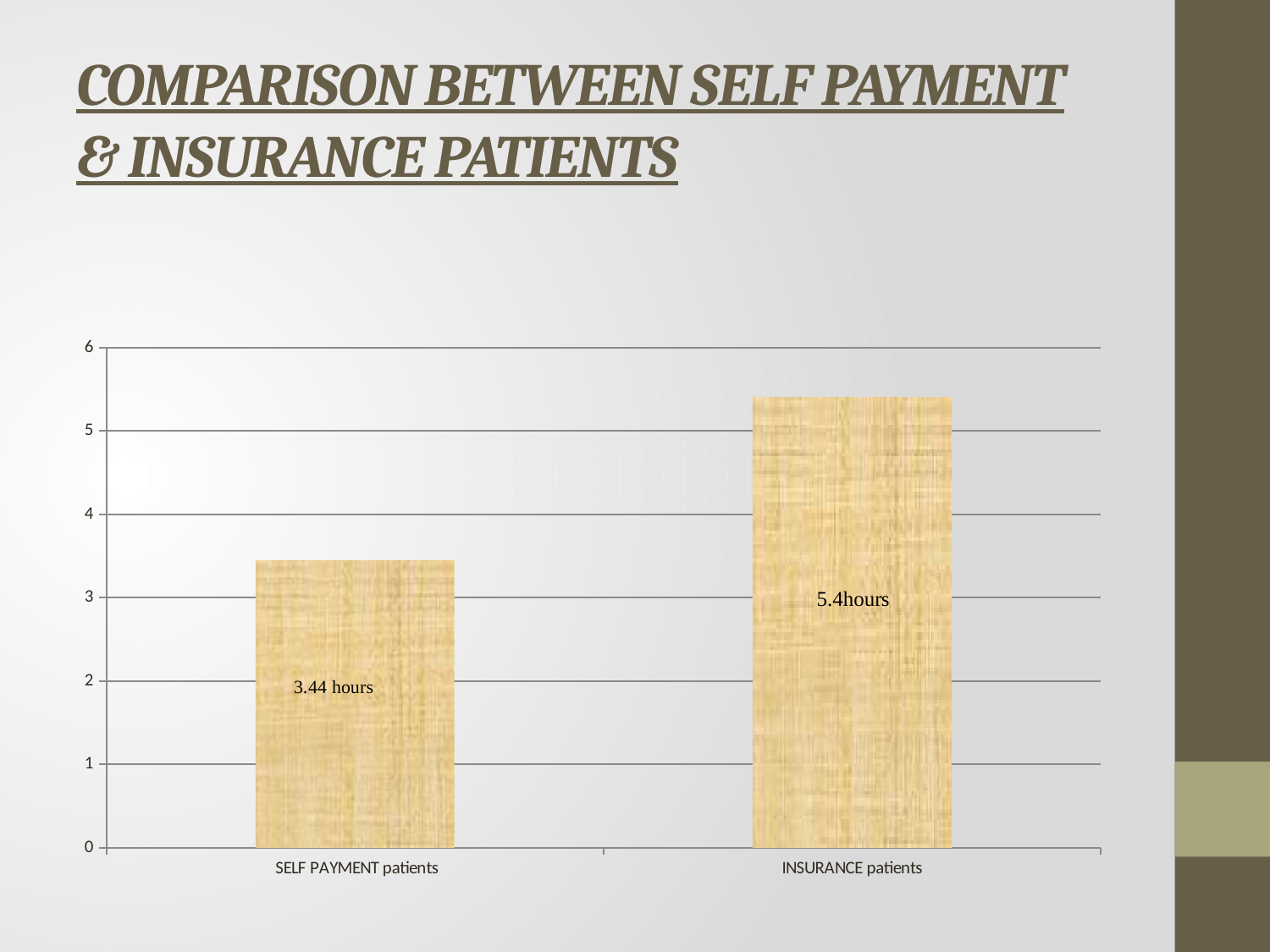
What kind of chart is shown on the slide? bar chart What is the title of the slide containing the chart? COMPARISON BETWEEN SELF PAYMENT & INSURANCE PATIENTS What is the difference in hours between INSURANCE patients and SELF PAYMENT patients? 1.96 hours Is the value for INSURANCE patients greater or less than 5? greater What is the value shown for SELF PAYMENT patients? 3.44 hours What is the value shown for INSURANCE patients? 5.4hours What is the highest tick value shown on the vertical axis? 6 Which category has the higher value? INSURANCE patients Is the value for SELF PAYMENT patients larger or smaller than the value for INSURANCE patients? smaller Which category has the lower value? SELF PAYMENT patients Is the value for SELF PAYMENT patients greater or less than 4? less How many categories are shown on the x axis? 2